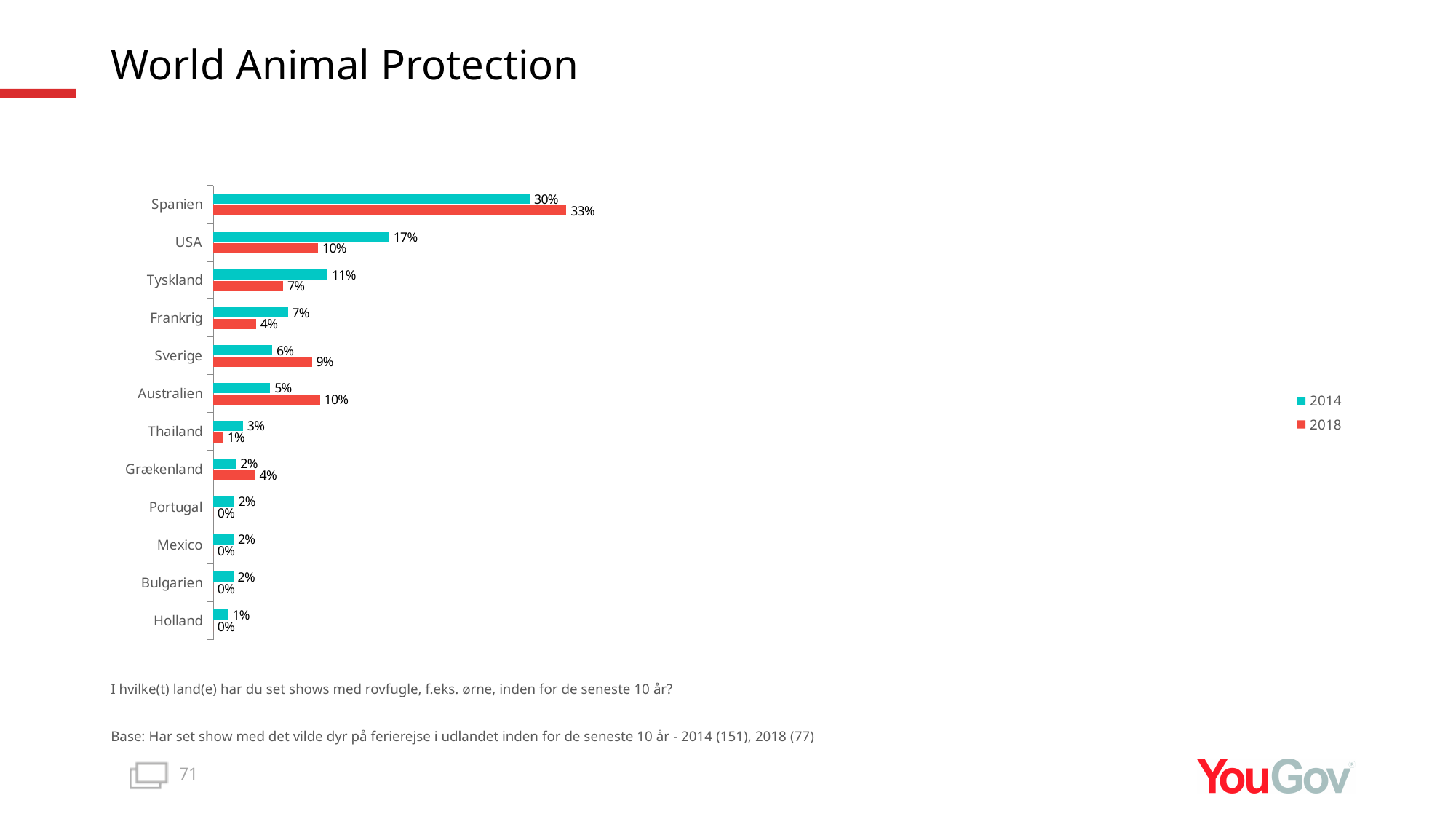
What is the difference between the 2018 and 2014 values for Spanien? 3% Which colour represents the 2018 series in the legend? Red How many series does the legend list? 2 What is the 2014 value for USA? 17% Which country has the highest 2014 value? Spanien Which is larger for Sverige, the 2014 value or the 2018 value? 2018 What is the difference between the 2014 and 2018 values for USA? 7% Which country has the lowest 2014 value? Holland How many countries are shown on the chart? 12 What is the 2018 value for Australien? 10% What kind of chart is shown on the slide? Bar chart What is the 2018 value for Spanien? 33%